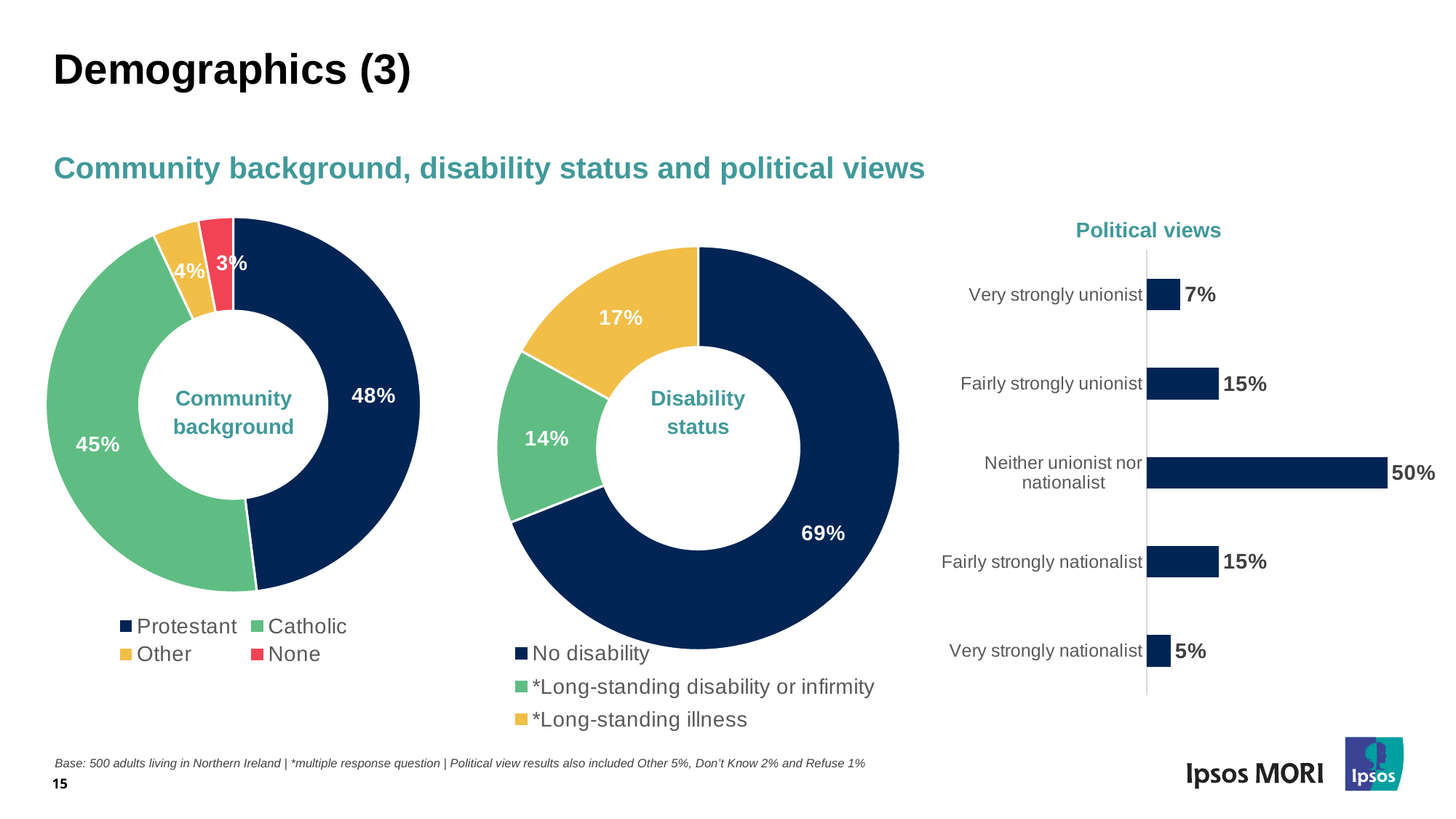
In the Disability status chart, which is larger: Long-standing disability or infirmity, or Long-standing illness? Long-standing illness In the Political views chart, what is the difference between Very strongly unionist and Very strongly nationalist? 2 percentage points What kind of chart is the Political views chart? Bar chart In the Community background chart, what percentage is Protestant? 48% In the Community background chart, what is the difference between the Protestant and Catholic shares? 3 percentage points In the Political views chart, what is the value for Neither unionist nor nationalist? 50% In the Disability status chart, what percentage is Long-standing illness? 17% How many categories does the Disability status chart legend list? 3 In the Political views chart, which category has the lowest value? Very strongly nationalist In the Community background chart, which category has the smallest share? None In the Community background chart, what percentage is Catholic? 45% In the Disability status chart, what percentage is No disability? 69%